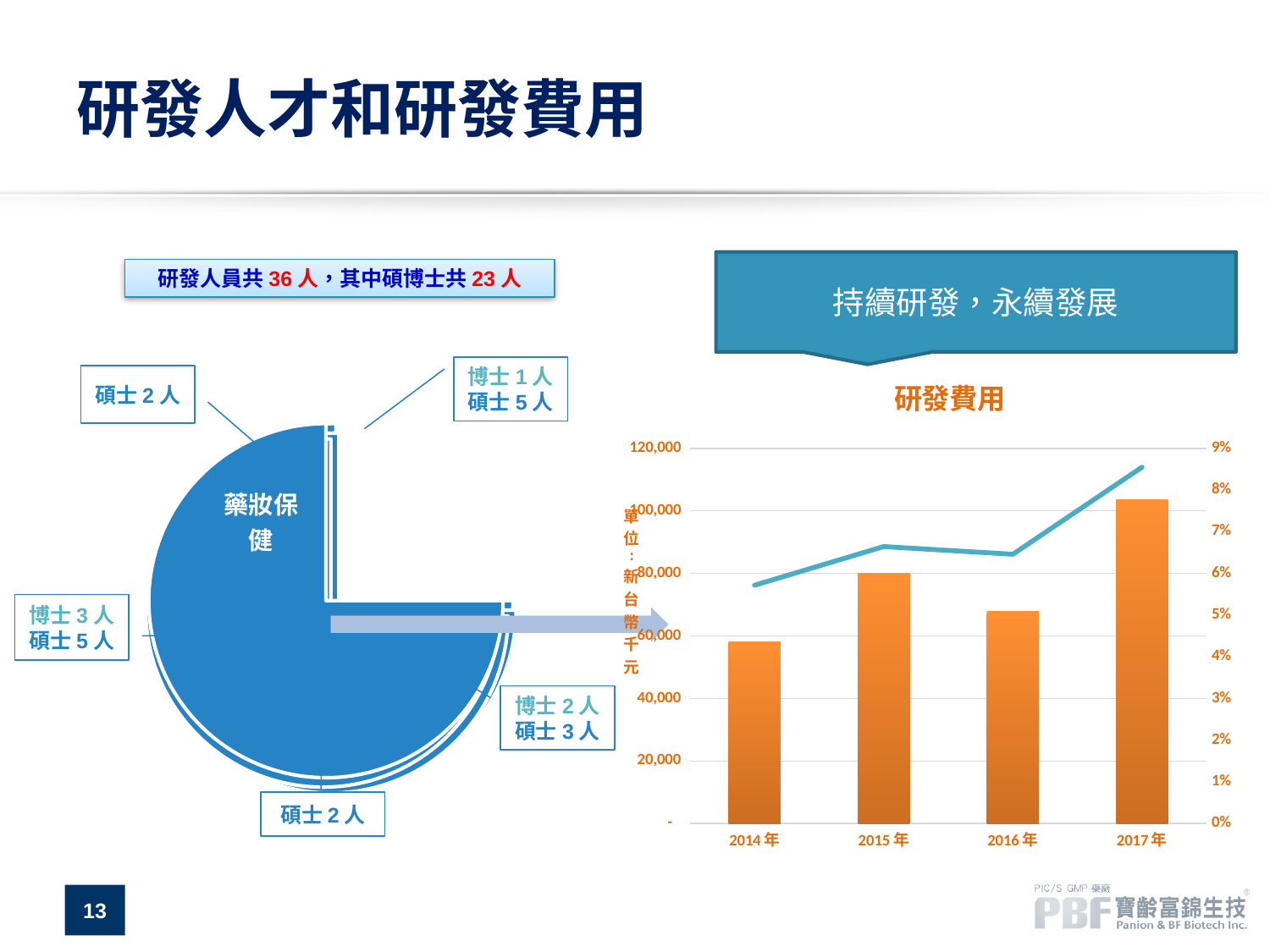
What kind of chart is shown on the left of the slide? pie chart In the 研發費用 chart, is the bar for 2014年 greater or less than 60,000? less In the 研發費用 chart, is the bar for 2017年 greater or less than 100,000? greater In the 研發費用 chart, how many years are shown on the x axis? 4 In the 研發費用 chart, which year has the tallest bar? 2017年 In the 研發費用 chart, which year has the shortest bar? 2014年 What kind of chart is the 研發費用 chart on the right of the slide? bar chart with a line In the 研發費用 chart, which bar is taller, 2015年 or 2016年? 2015年 In the 研發費用 chart, does the line rise or fall from 2016年 to 2017年? rises In the 研發費用 chart, is the bar for 2016年 greater or less than 60,000? greater What label is written on the largest slice of the pie chart on the left? 藥妝保健